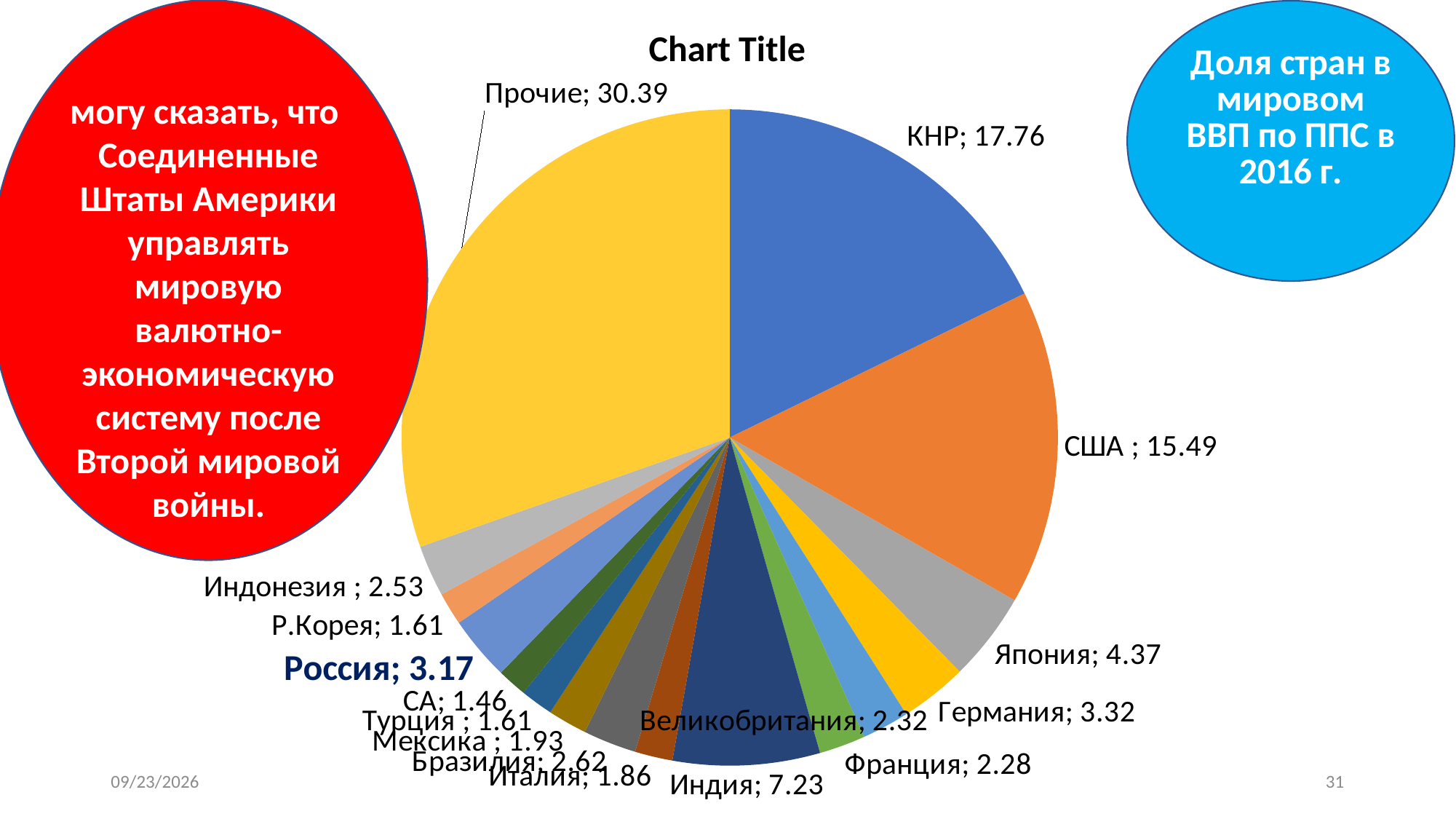
What kind of chart is shown on the slide? pie chart What is the value shown for США? 15.49 What is the value shown for КНР? 17.76 What is the difference between the values for КНР and США? 2.27 Which is larger, the value for Япония or the value for Германия? Япония What is the title printed above the pie chart? Chart Title Which slice has the largest value? Прочие What is the difference between the values for Прочие and КНР? 12.63 Which slice has the smallest value? СА What is the value shown for Индия? 7.23 What is the value shown for Россия? 3.17 How many slices does the pie chart have? 16